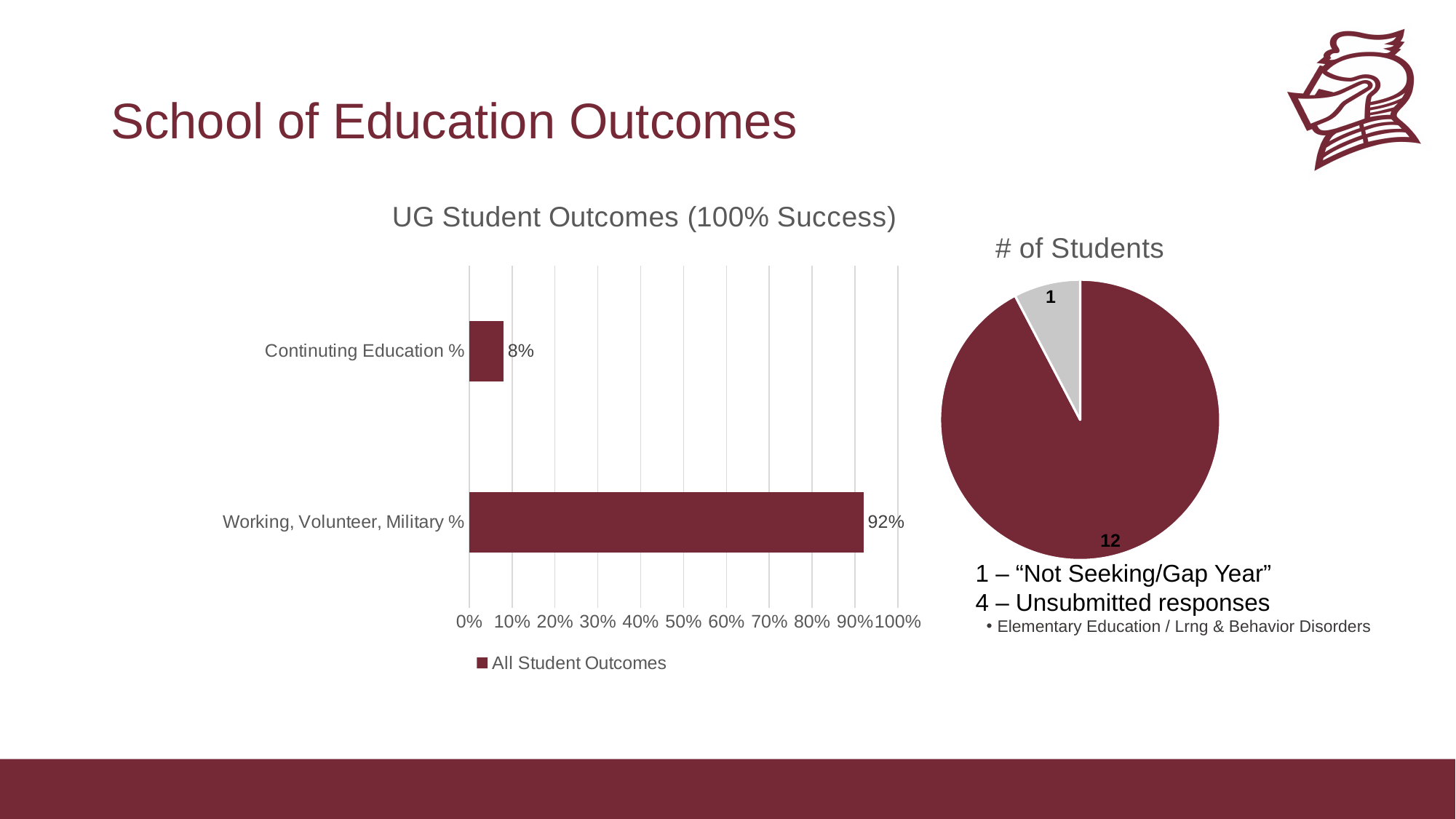
In the '# of Students' pie chart, what is the value of the largest slice? 12 In the '# of Students' pie chart, what is the total of the two slices? 13 In the 'UG Student Outcomes (100% Success)' chart, what is the difference between the Working, Volunteer, Military % value and the Continuting Education % value? 84% In the 'UG Student Outcomes (100% Success)' chart, which category has the highest value? Working, Volunteer, Military % In the '# of Students' pie chart, what is the value of the smallest slice? 1 In the 'UG Student Outcomes (100% Success)' chart, what is the value for Continuting Education %? 8% In the 'UG Student Outcomes (100% Success)' chart, what is the value for Working, Volunteer, Military %? 92% In the 'UG Student Outcomes (100% Success)' chart, what series does the legend list? All Student Outcomes In the 'UG Student Outcomes (100% Success)' chart, which category has the lowest value? Continuting Education % What kind of chart is 'UG Student Outcomes (100% Success)'? Bar chart In the 'UG Student Outcomes (100% Success)' chart, how many categories are shown? 2 What kind of chart is '# of Students'? Pie chart